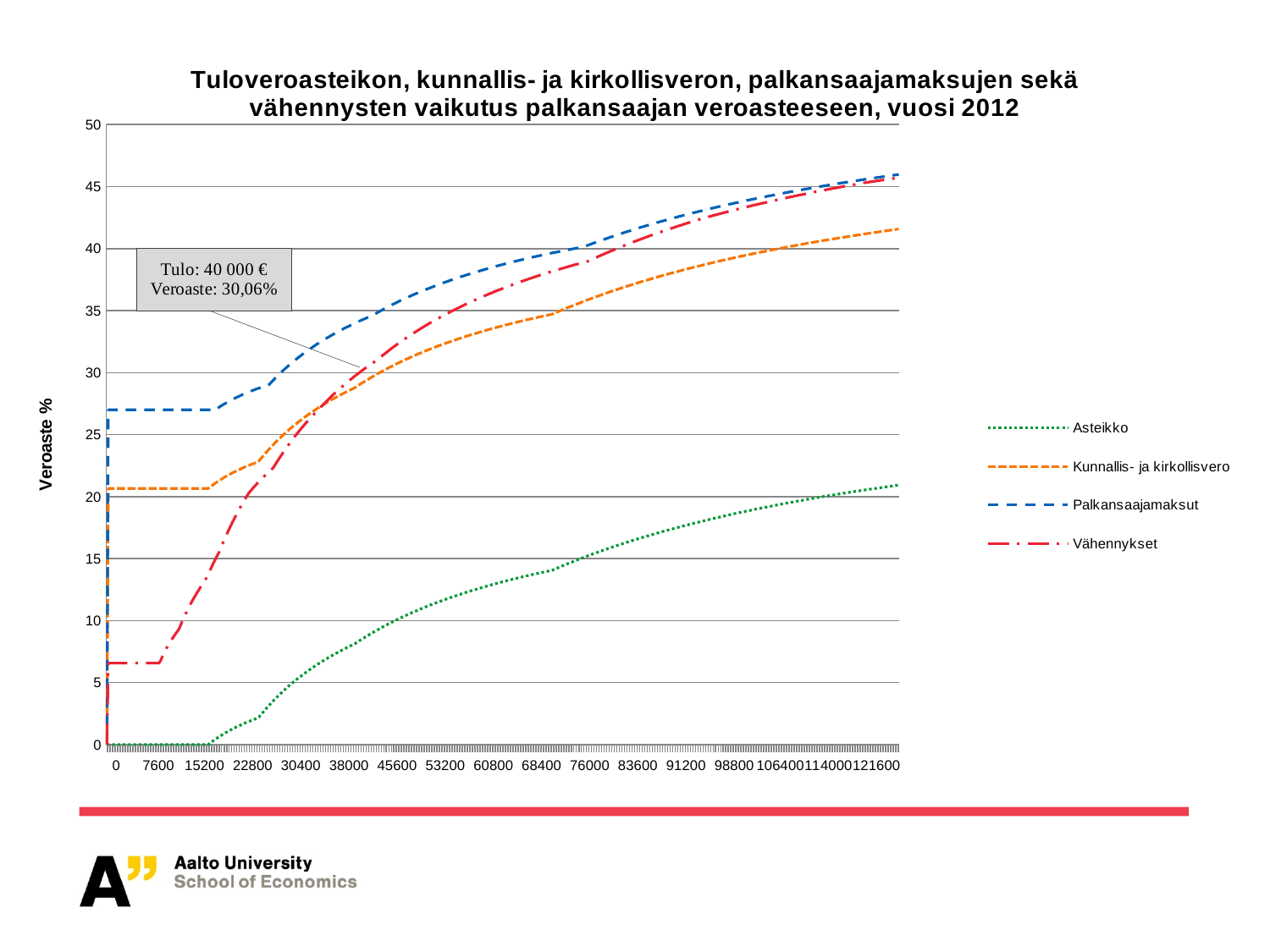
Which series has the lowest values across the whole income range? Asteikko What is the label of the vertical axis? Veroaste % How many series does the legend list? 4 At income 121600, which is higher: Palkansaajamaksut or Kunnallis- ja kirkollisvero? Palkansaajamaksut According to the annotation, what is the tax rate (veroaste) at an income of 40 000 €? 30,06% What kind of chart is shown on the slide? line chart Which series is drawn with the green dotted line? Asteikko Does the Asteikko series rise or fall as income increases along the x axis? rise Is the value of Asteikko at income 60800 greater or less than 10? greater At income 22800, which is higher: Palkansaajamaksut or Vähennykset? Palkansaajamaksut Is the value of Vähennykset at income 7600 greater or less than 10? less